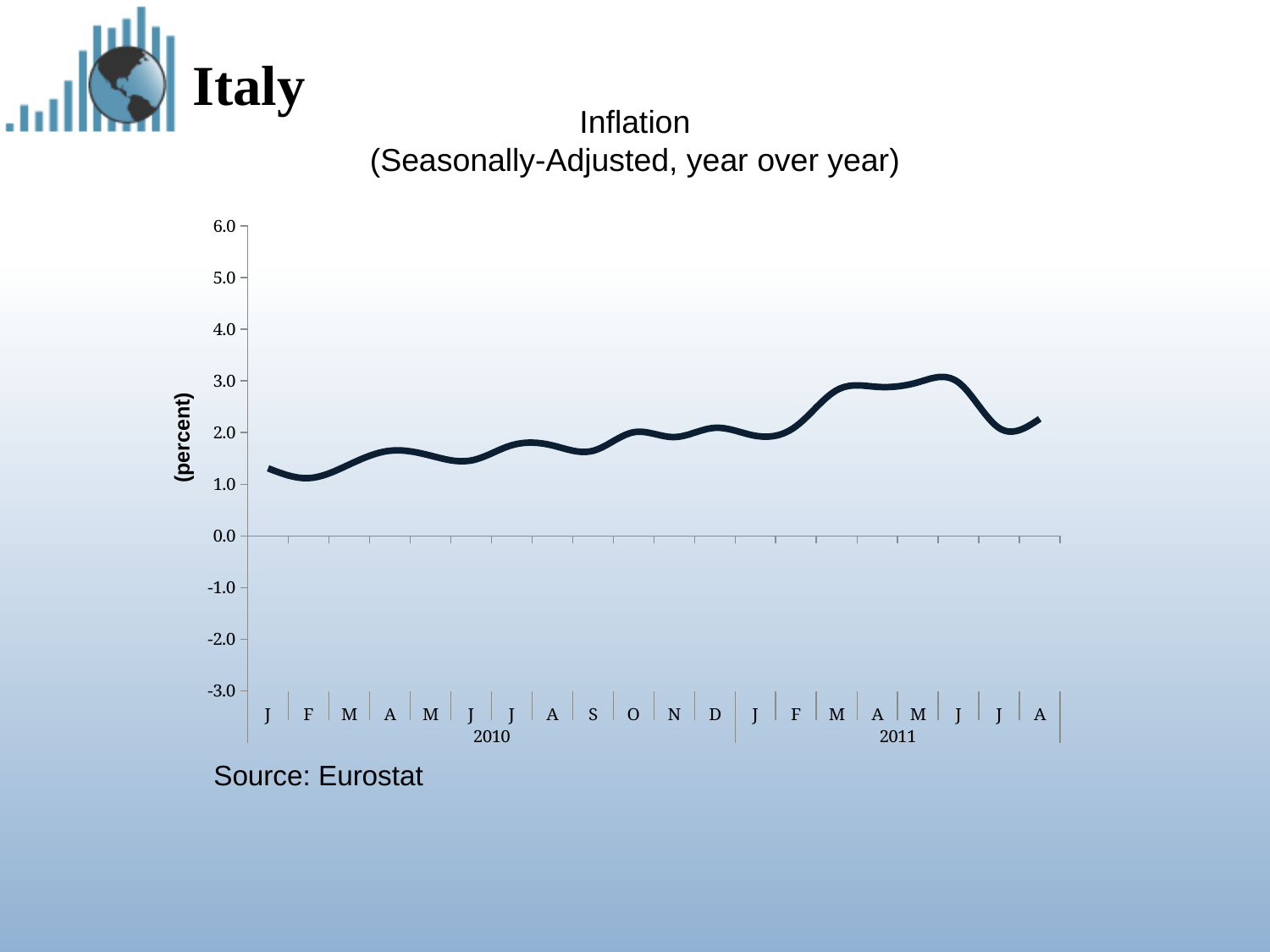
In which month does the inflation line reach its lowest value? February 2010 What is the label on the vertical axis of the chart? (percent) Is the value for March 2011 greater or less than 2.0? greater Does the inflation line rise or fall between June 2011 and July 2011? fall What kind of chart is shown on the slide? line chart Which is larger, the value for March 2010 or the value for March 2011? March 2011 What is the title of the chart? Inflation (Seasonally-Adjusted, year over year) Is the value for June 2011 greater or less than 2.0? greater How many monthly data points are plotted on the chart? 20 Is the value for February 2010 greater or less than 1.0? greater